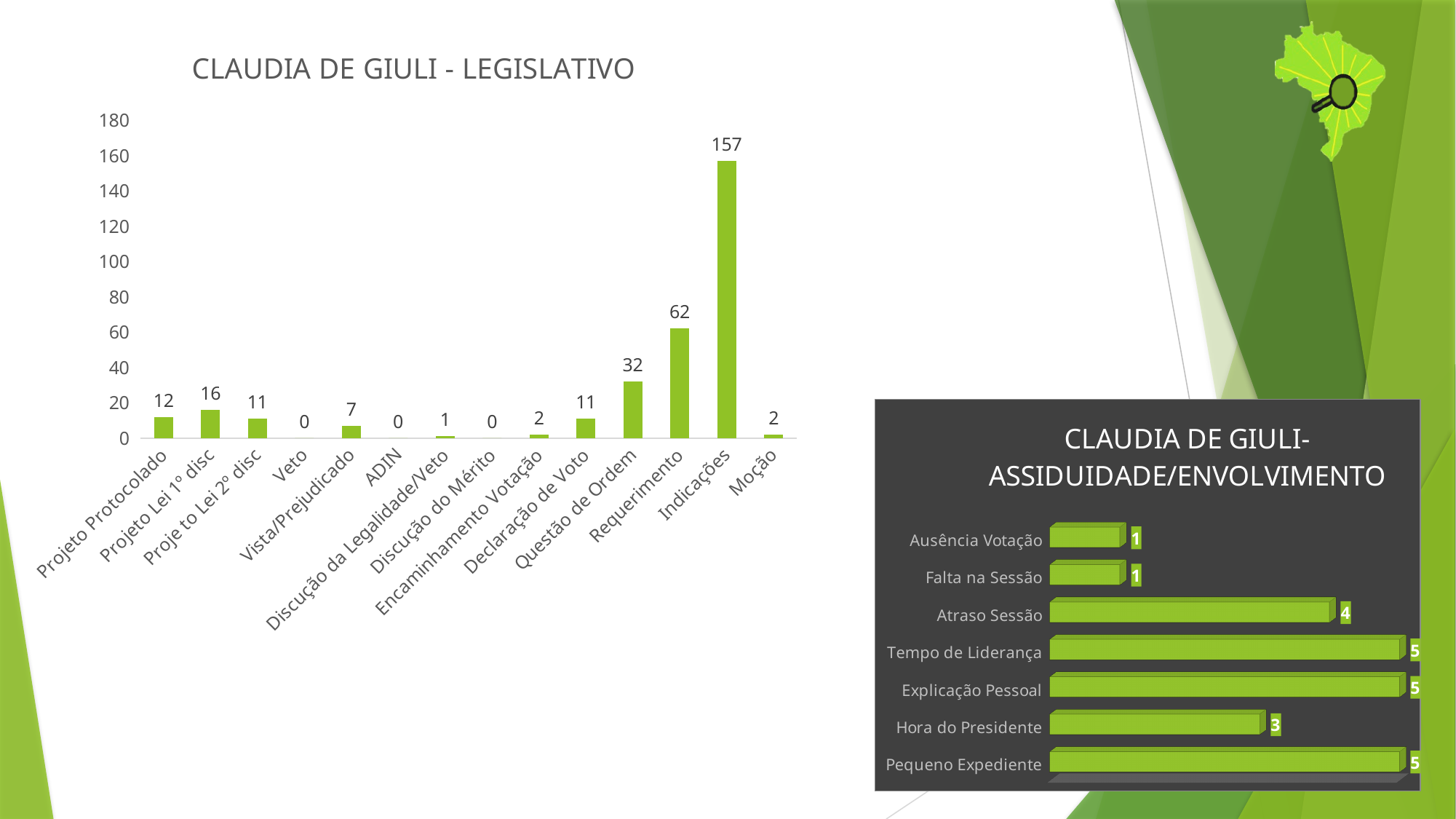
In the 'CLAUDIA DE GIULI - LEGISLATIVO' chart, what is the value for Indicações? 157 In the 'CLAUDIA DE GIULI- ASSIDUIDADE/ENVOLVIMENTO' chart, how many categories are shown? 7 What kind of chart is 'CLAUDIA DE GIULI - LEGISLATIVO'? Bar chart In the 'CLAUDIA DE GIULI - LEGISLATIVO' chart, which category has the highest value? Indicações In the 'CLAUDIA DE GIULI - LEGISLATIVO' chart, what is the value for Questão de Ordem? 32 In the 'CLAUDIA DE GIULI - LEGISLATIVO' chart, how many categories are shown on the x axis? 14 In the 'CLAUDIA DE GIULI- ASSIDUIDADE/ENVOLVIMENTO' chart, which is larger, Atraso Sessão or Falta na Sessão? Atraso Sessão In the 'CLAUDIA DE GIULI - LEGISLATIVO' chart, what is the difference between Indicações and Requerimento? 95 In the 'CLAUDIA DE GIULI - LEGISLATIVO' chart, what is the value for Requerimento? 62 In the 'CLAUDIA DE GIULI- ASSIDUIDADE/ENVOLVIMENTO' chart, what is the value for Hora do Presidente? 3 In the 'CLAUDIA DE GIULI- ASSIDUIDADE/ENVOLVIMENTO' chart, what is the value for Atraso Sessão? 4 In the 'CLAUDIA DE GIULI - LEGISLATIVO' chart, which is larger, Projeto Protocolado or Projeto Lei 1° disc? Projeto Lei 1° disc